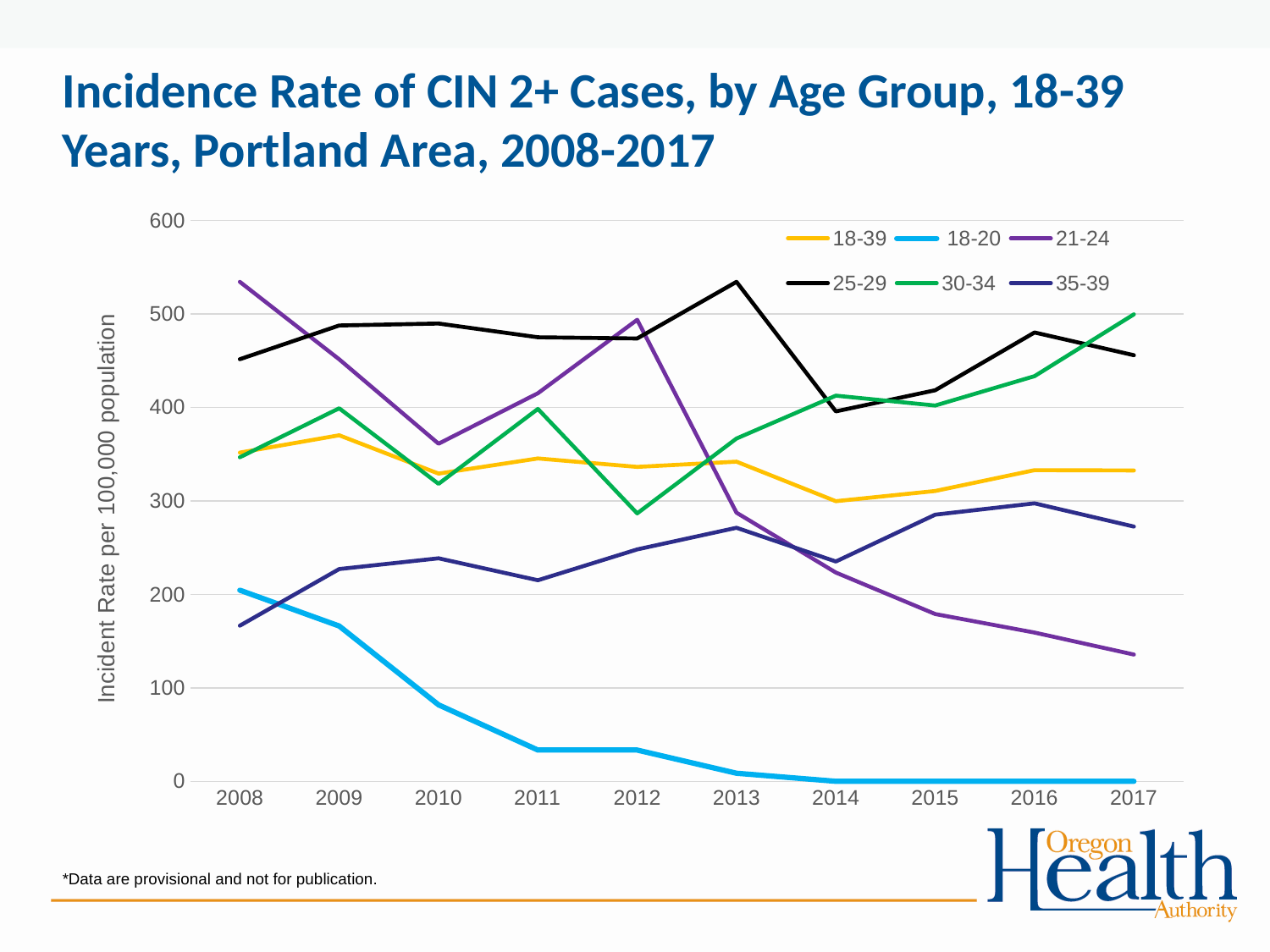
How many series does the legend list? 6 Is the value for the 35-39 age group in 2008 greater or less than 200? less What is the label on the y axis of the chart? Incident Rate per 100,000 population Is the value for the 18-20 age group in 2010 greater or less than 100? less How many years are shown on the x axis? 10 Which age group has the lowest incidence rate in 2017? 18-20 What kind of chart is shown on the slide? Line chart Which age group has the highest incidence rate in 2008? 21-24 Is the value for the 25-29 age group in 2013 greater or less than 500? greater In 2017, which has the higher incidence rate: the 30-34 age group or the 25-29 age group? 30-34 Does the incidence rate for the 18-20 age group rise or fall from 2008 to 2017? Fall Does the incidence rate for the 21-24 age group rise or fall from 2012 to 2017? Fall